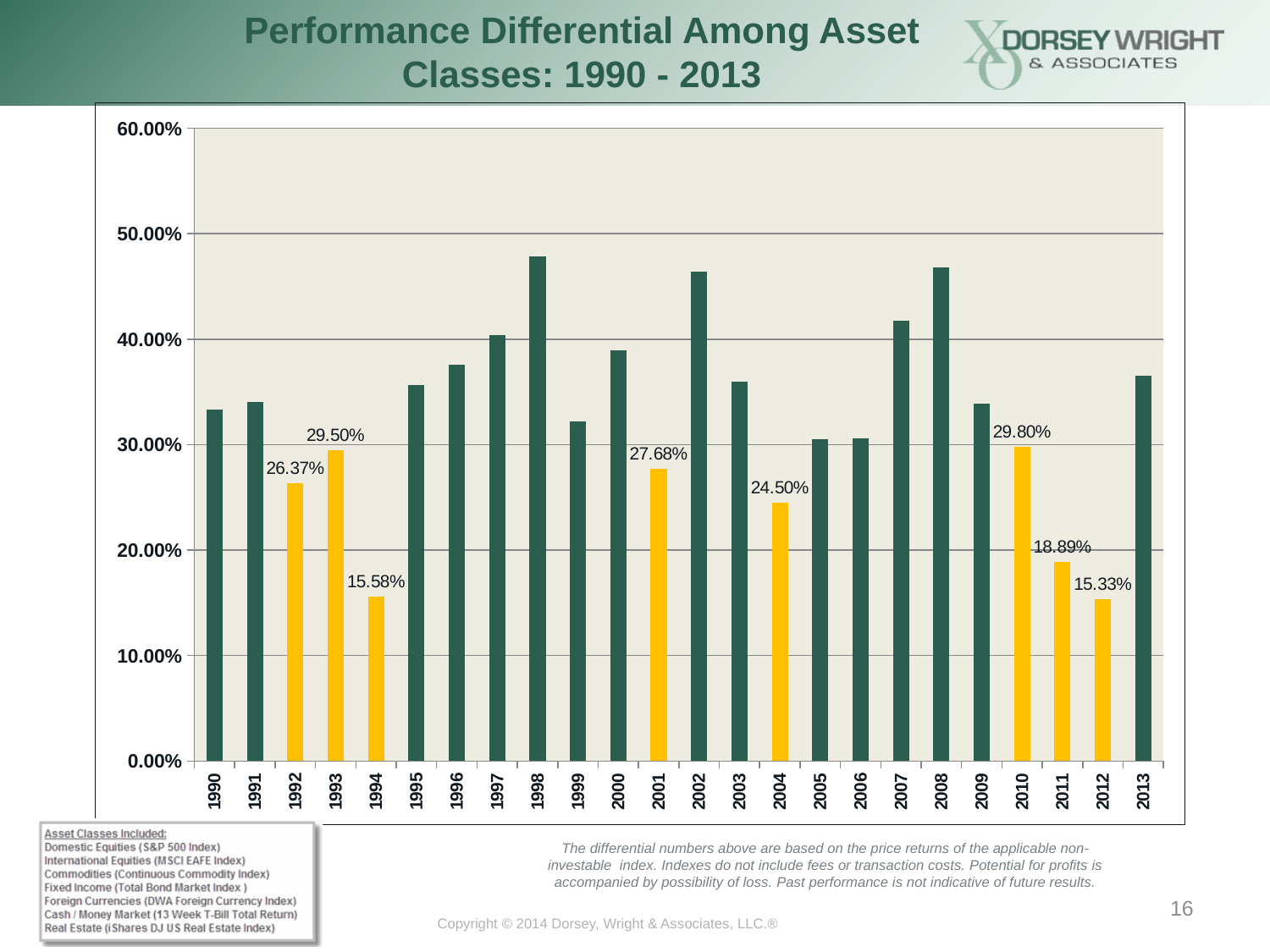
Is the value for 2013 greater or less than 40.00%? less What is the difference between the values for 2010 and 2012? 14.47% Is the value for 1998 greater or less than 40.00%? greater What is the value shown for 2011? 18.89% Which year has the lowest value on the chart? 2012 What kind of chart is shown on the slide? Bar chart What is the difference between the values for 1993 and 1992? 3.13% What is the value shown for 2010? 29.80% What is the value shown for 1992? 26.37% How many years are shown on the x axis? 24 Which is larger, the value for 2001 or the value for 2004? 2001 What is the value shown for 2004? 24.50%